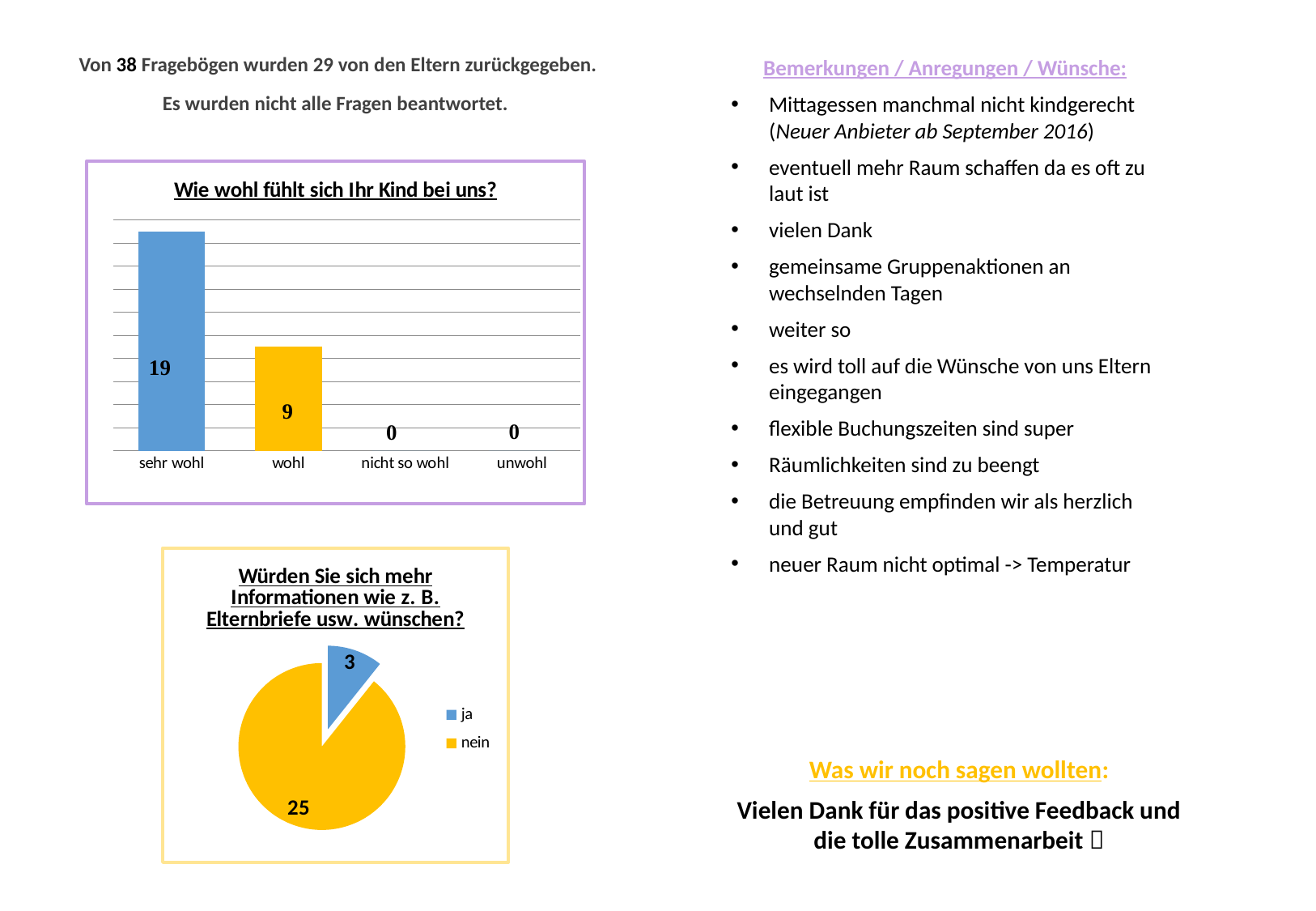
In the chart 'Wie wohl fühlt sich Ihr Kind bei uns?', what is the value for 'sehr wohl'? 19 In the chart 'Wie wohl fühlt sich Ihr Kind bei uns?', how many categories are shown on the x axis? 4 In the chart 'Wie wohl fühlt sich Ihr Kind bei uns?', what is the difference between 'sehr wohl' and 'wohl'? 10 In the chart 'Wie wohl fühlt sich Ihr Kind bei uns?', do the values rise or fall from left to right along the x axis? fall What kind of chart is 'Wie wohl fühlt sich Ihr Kind bei uns?'? bar chart In the pie chart 'Würden Sie sich mehr Informationen wie z. B. Elternbriefe usw. wünschen?', what is the value for 'ja'? 3 In the chart 'Wie wohl fühlt sich Ihr Kind bei uns?', what is the value for 'unwohl'? 0 In the chart 'Wie wohl fühlt sich Ihr Kind bei uns?', which category has the highest value? sehr wohl In the pie chart 'Würden Sie sich mehr Informationen wie z. B. Elternbriefe usw. wünschen?', what is the value for 'nein'? 25 In the pie chart 'Würden Sie sich mehr Informationen wie z. B. Elternbriefe usw. wünschen?', which is larger, 'ja' or 'nein'? nein In the pie chart 'Würden Sie sich mehr Informationen wie z. B. Elternbriefe usw. wünschen?', how many entries does the legend list? 2 In the chart 'Wie wohl fühlt sich Ihr Kind bei uns?', what is the value for 'wohl'? 9